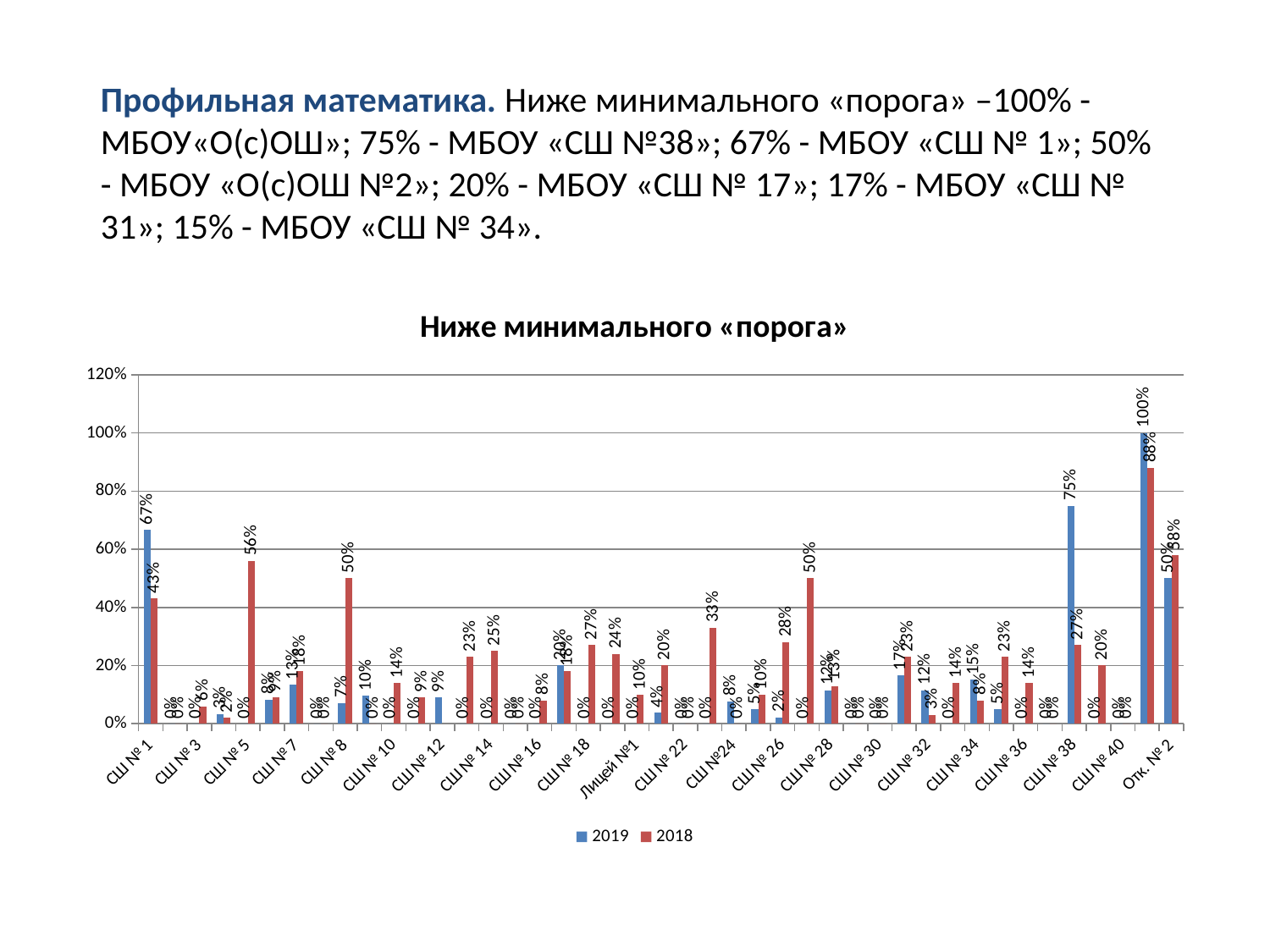
What kind of chart is shown on the slide? bar chart What is the 2019 value for СШ № 1? 67% What is the 2018 value for СШ № 8? 50% What is the title of the chart? Ниже минимального «порога» What is the 2018 value for СШ № 5? 56% What is the 2019 value for СШ № 38? 75% What is the highest value in the 2019 series? 100% For СШ № 38, which series has the larger value, 2019 or 2018? 2019 What is the 2019 value for СШ № 34? 15% What is the difference between the 2019 and 2018 values for СШ № 1? 24% How many series does the chart legend list? 2 What is the 2018 value for СШ № 1? 43%